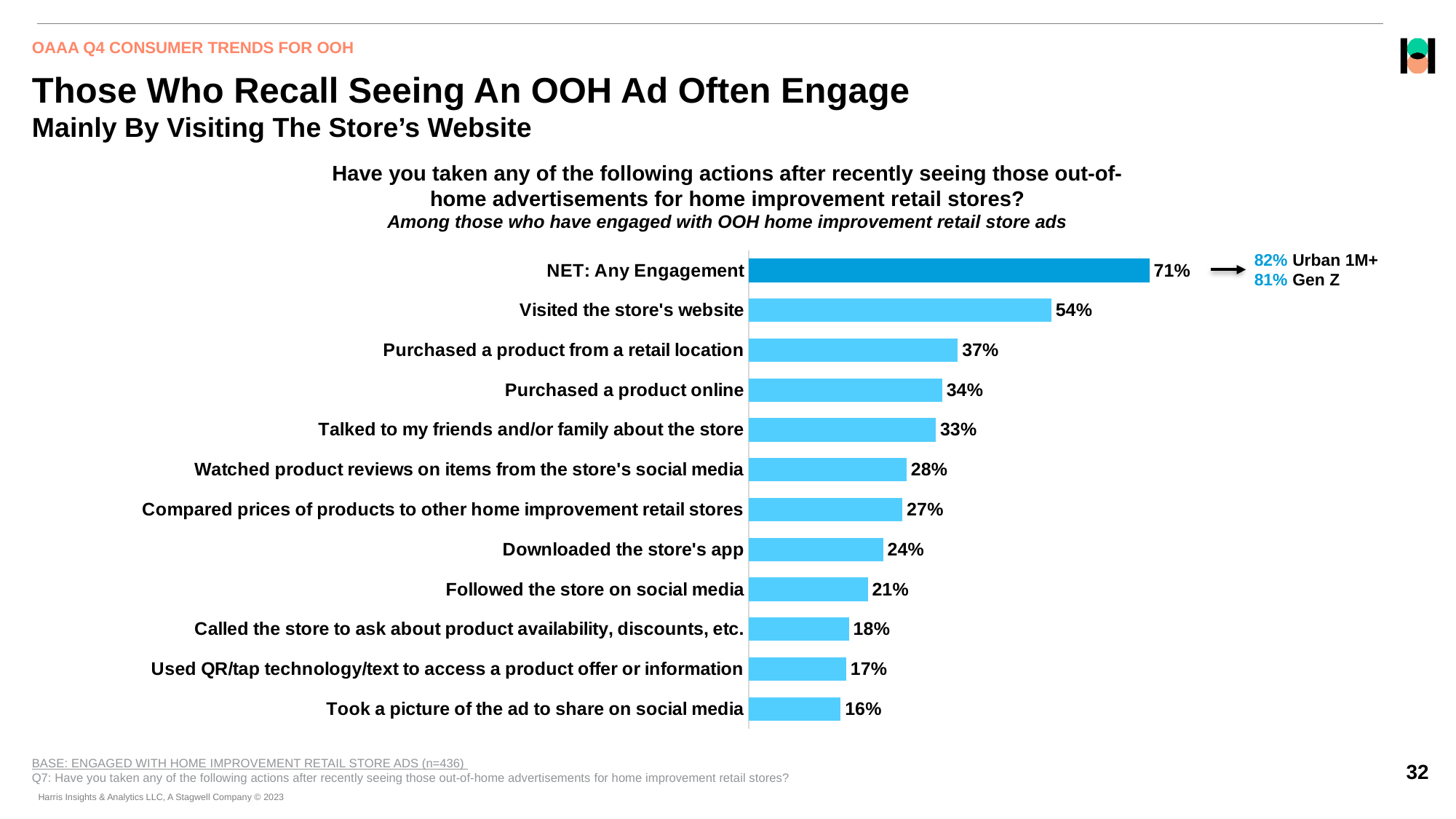
Which action has the lowest percentage? Took a picture of the ad to share on social media What percentage of Urban 1M+ respondents reported any engagement, according to the annotation? 82% How many bars are shown in the chart, including the NET bar? 12 What is the base sample size (n) noted at the bottom of the slide? n=436 Which is larger: 'Followed the store on social media' or 'Called the store to ask about product availability, discounts, etc.'? Followed the store on social media What is the value shown for 'NET: Any Engagement'? 71% What percentage downloaded the store's app? 24% What type of chart is shown on the slide? Bar chart What percentage of respondents visited the store's website after seeing the OOH ad? 54% What percentage of Gen Z respondents reported any engagement, according to the annotation? 81% Excluding the NET bar, which action has the highest percentage? Visited the store's website What is the difference between 'Purchased a product from a retail location' and 'Purchased a product online'? 3%